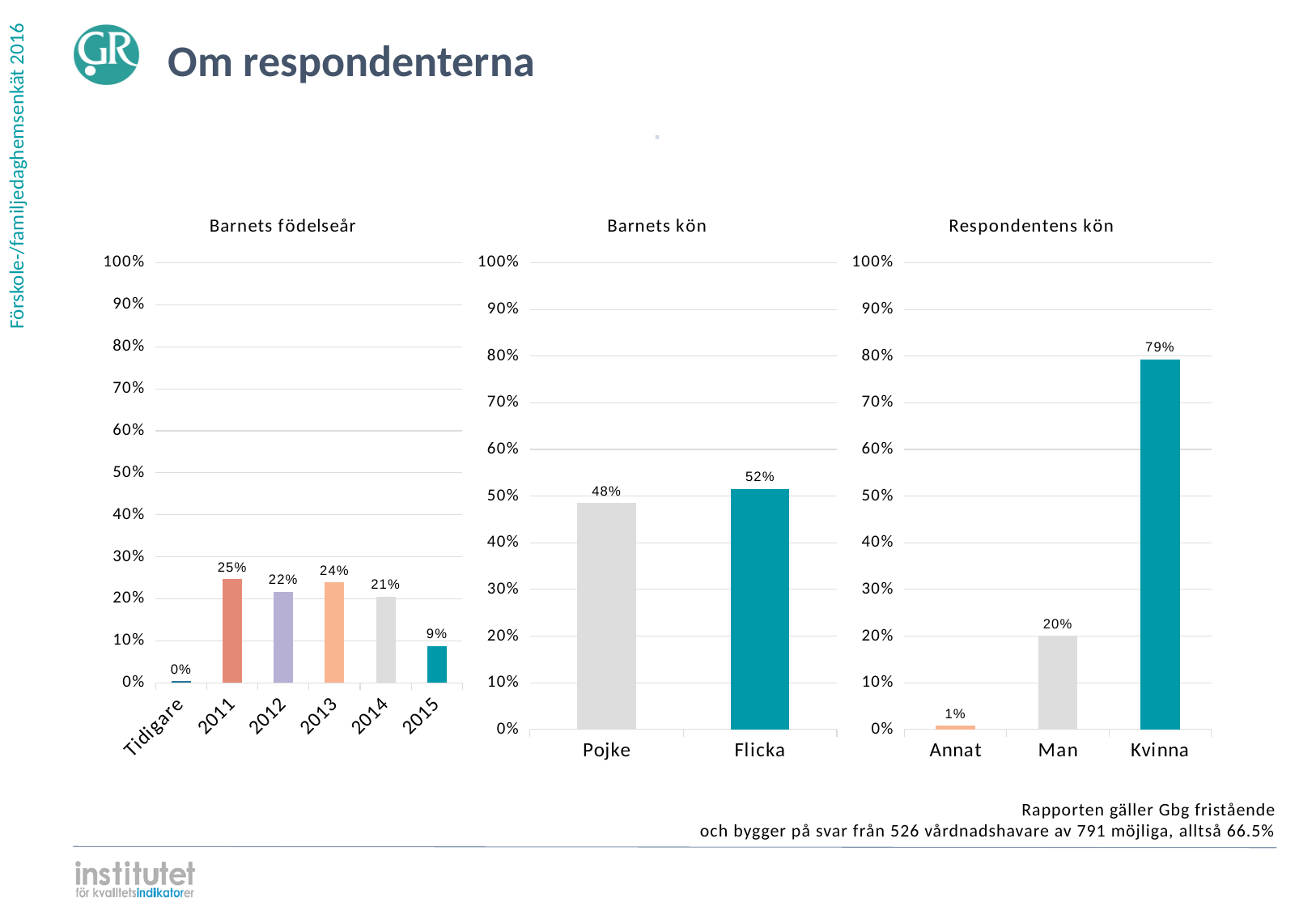
In the 'Barnets födelseår' chart, what is the value for 2013? 24% In the 'Barnets födelseår' chart, how many categories are shown on the x axis? 6 In the 'Barnets kön' chart, what is the value for Pojke? 48% In the 'Respondentens kön' chart, which category has the lowest value? Annat In the 'Barnets kön' chart, what is the difference between Flicka and Pojke? 4% In the 'Barnets kön' chart, which is larger, Pojke or Flicka? Flicka In the 'Barnets födelseår' chart, which category has the highest value? 2011 In the 'Respondentens kön' chart, what is the value for Kvinna? 79% In the 'Barnets födelseår' chart, which category has the lowest value? Tidigare In the 'Barnets födelseår' chart, what is the difference between the values for 2011 and 2015? 16% In the 'Respondentens kön' chart, what is the difference between Kvinna and Man? 59% What kind of chart is the 'Respondentens kön' chart? Bar chart